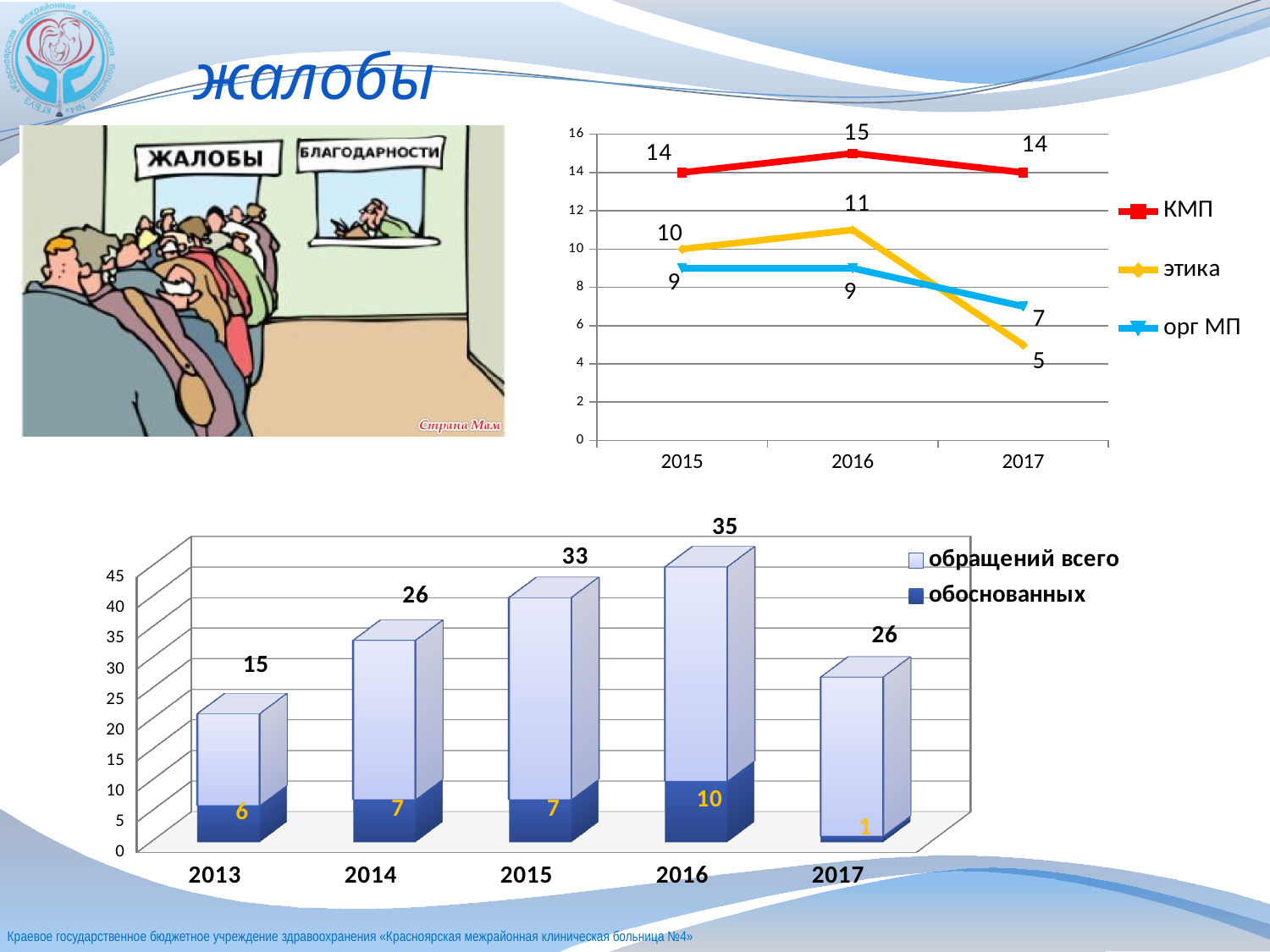
In the bottom bar chart, what is the value for обращений всего in 2016? 35 What kind of chart is the bottom chart on the slide? bar chart In the bottom bar chart, which year has the lowest value for обращений всего? 2013 In the top-right line chart, what is the value for этика in 2017? 5 In the bottom bar chart, what is the value for обоснованных in 2017? 1 In the top-right line chart, what is the difference between the этика values for 2016 and 2017? 6 In the top-right line chart, what is the value for КМП in 2016? 15 In the top-right line chart, how many series does the legend list? 3 In the top-right line chart, does the этика series rise or fall from 2016 to 2017? fall In the bottom bar chart, how many years are shown on the x axis? 5 In the top-right line chart, what is the value for орг МП in 2015? 9 In the top-right line chart, which series has the highest value in 2017? КМП